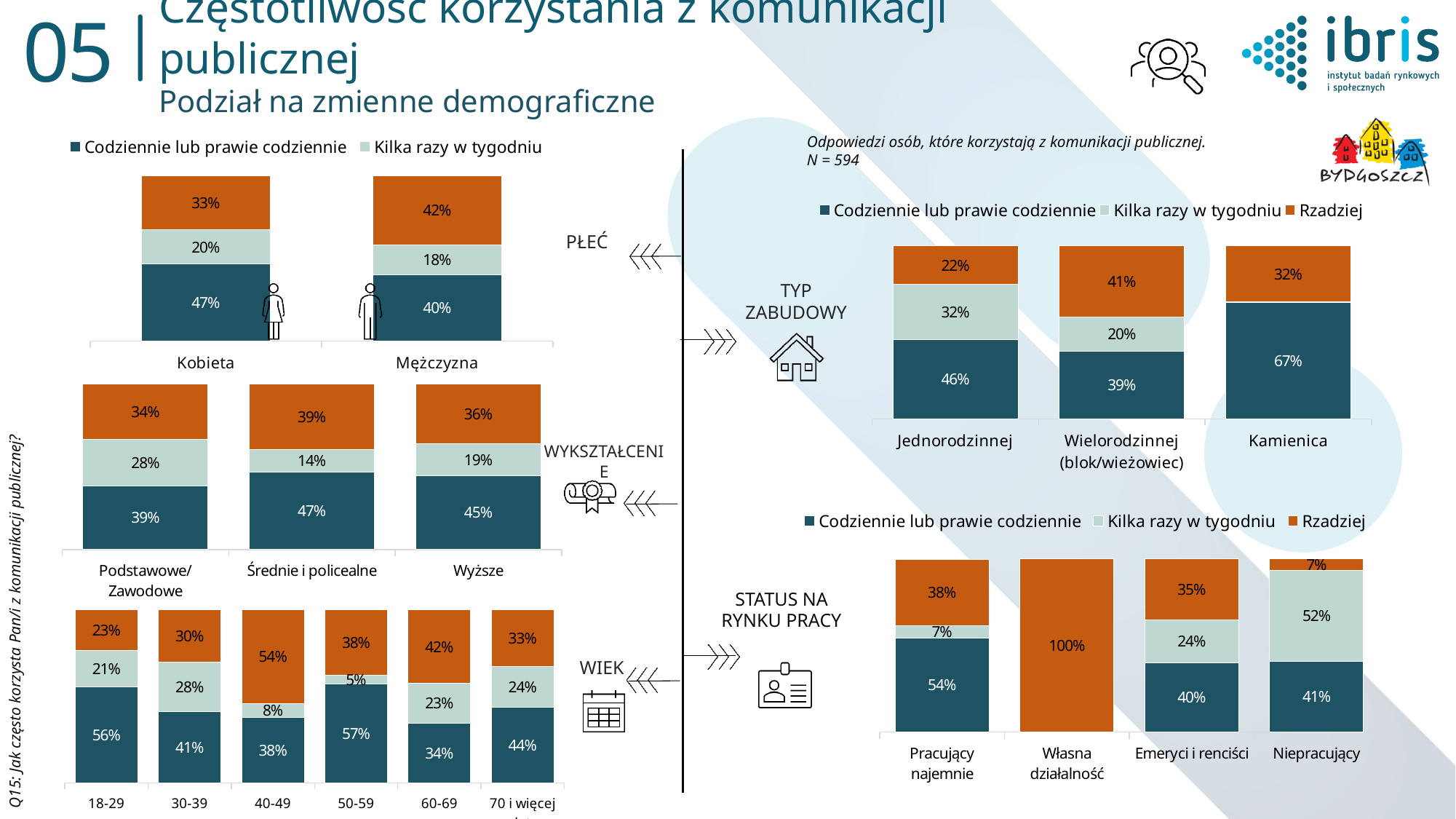
In the WIEK chart, which age group has the highest 'Codziennie lub prawie codziennie' share? 50-59 What is the sample size (N) stated on the slide for respondents who use public transport? N = 594 In the WIEK chart, what is the 'Rzadziej' value for the 40-49 age group? 54% How many series does the legend of the TYP ZABUDOWY chart list? 3 How many categories are shown in the STATUS NA RYNKU PRACY chart? 4 In the PŁEĆ chart, what is the difference between the 'Rzadziej' values for Mężczyzna and Kobieta? 9 percentage points In the STATUS NA RYNKU PRACY chart, what is the 'Rzadziej' value for Własna działalność? 100% What type of chart is used for the WIEK data? Stacked bar chart In the WYKSZTAŁCENIE chart, which has the larger 'Kilka razy w tygodniu' value: Podstawowe/Zawodowe or Wyższe? Podstawowe/Zawodowe In the WIEK chart, which age group has the lowest 'Kilka razy w tygodniu' value? 50-59 In the PŁEĆ chart, what percentage of Kobieta respondents use public transport 'Codziennie lub prawie codziennie'? 47% In the TYP ZABUDOWY chart, what is the 'Codziennie lub prawie codziennie' value for Kamienica? 67%